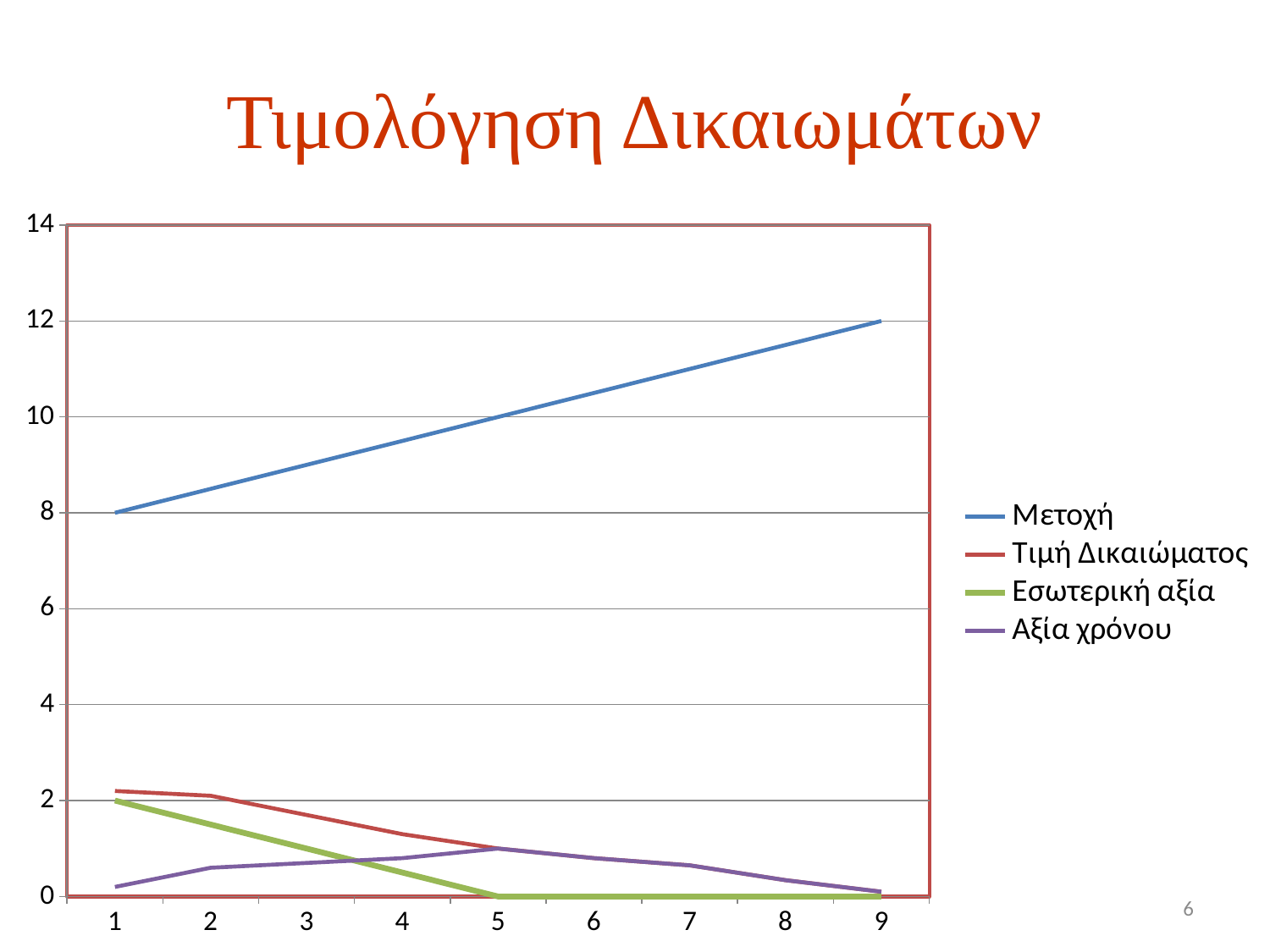
What is the value of Μετοχή at x = 1? 8 Which series has the highest values across the chart? Μετοχή Is the value for Τιμή Δικαιώματος at x = 1 greater or less than 4? less What is the title of the chart slide? Τιμολόγηση Δικαιωμάτων What is the value of Εσωτερική αξία at x = 1? 2 What kind of chart is shown on the slide? line chart How many points are labelled on the x axis? 9 What is the value of Εσωτερική αξία at x = 7? 0 Does the Μετοχή series rise or fall from x = 1 to x = 9? rise What is the value of Μετοχή at x = 9? 12 How many series does the legend list? 4 Does the Εσωτερική αξία series rise or fall from x = 1 to x = 5? fall